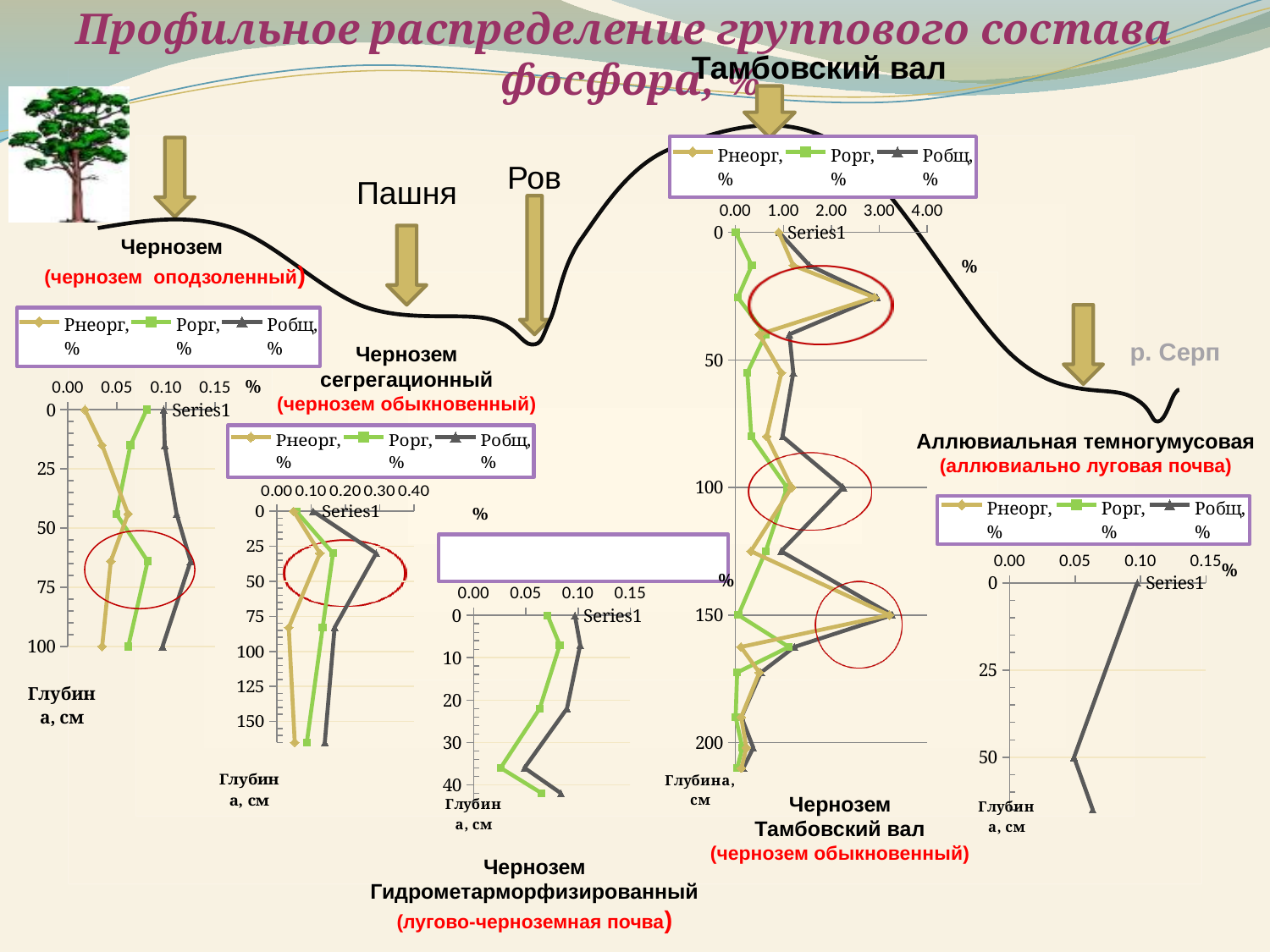
In the Чернозем Тамбовский вал chart, at depth 150 cm, which is larger: Робщ or Рорг? Робщ In the Чернозем сегрегационный chart, is the Робщ value at depth 25 cm greater or less than 0.20? greater In the Чернозем Гидрометаморфизированный chart, is the Робщ value at depth 0 cm greater or less than 0.05? greater In the Аллювиальная темногумусовая chart, does the Робщ value increase or decrease from depth 0 cm to depth 50 cm? decrease What are the three series named in the legend of the Чернозем (чернозем оподзоленный) chart? Рнеорг, %; Рорг, %; Робщ, % What kind of chart is used for the Чернозем Тамбовский вал profile? line chart In the Чернозем (чернозем оподзоленный) chart, is the Рнеорг value at depth 0 cm greater or less than 0.05? less How many profile charts are shown on the slide? 5 In the Чернозем Тамбовский вал chart, which series has the highest value at depth 100 cm? Робщ, % How many series does the legend of the Чернозем Тамбовский вал chart list? 3